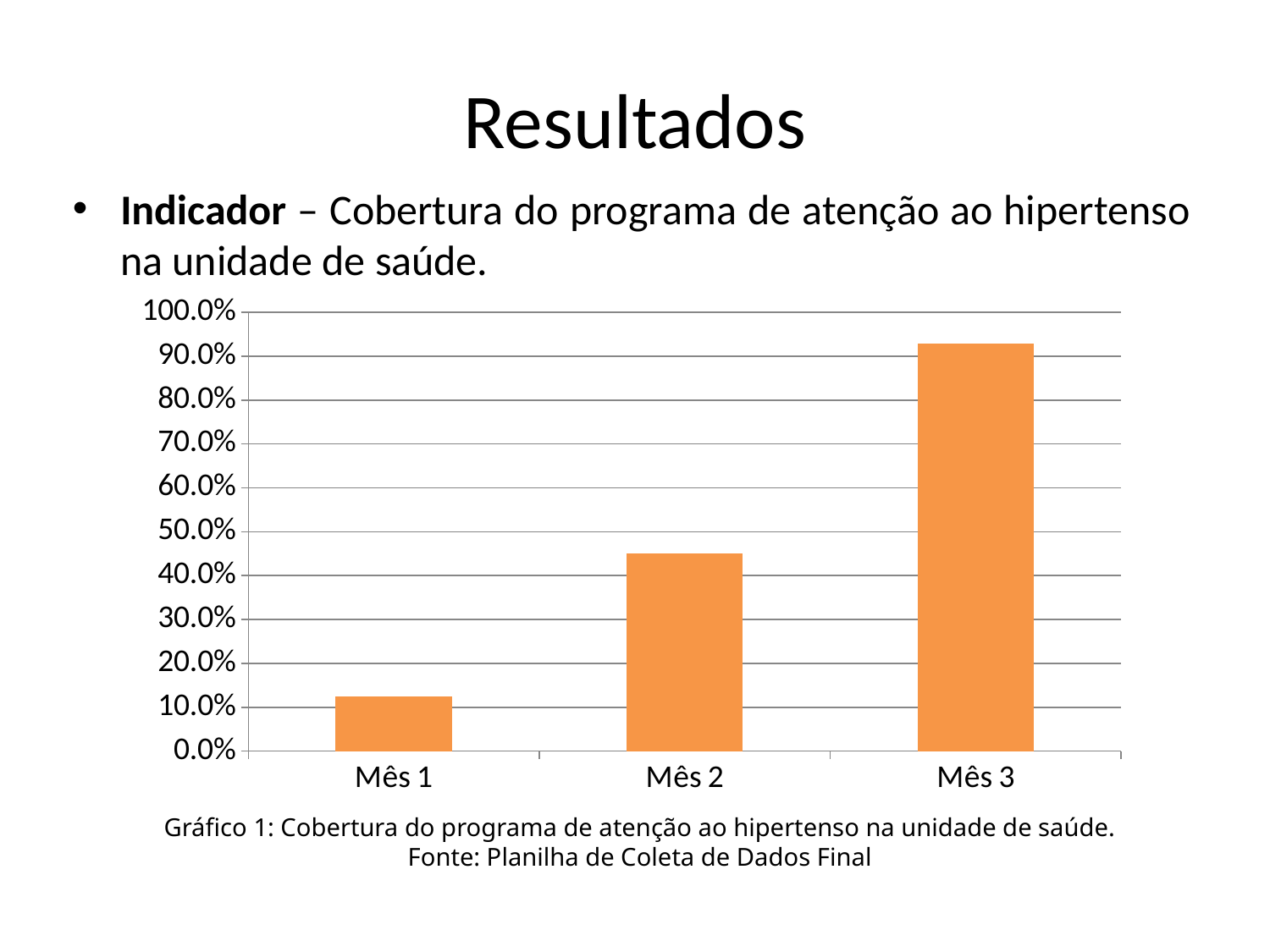
How many categories (months) are plotted on the chart? 3 Which is larger, the value for Mês 2 or the value for Mês 3? Mês 3 Which month has the highest coverage value? Mês 3 What is the caption given for the chart (Gráfico 1)? Cobertura do programa de atenção ao hipertenso na unidade de saúde. Which month has the lowest coverage value? Mês 1 Is the value for Mês 2 greater or less than 50.0%? less Is the value for Mês 2 greater or less than 40.0%? greater What is the maximum value shown on the vertical axis? 100.0% What kind of chart is shown on the slide? bar chart Is the value for Mês 1 greater or less than 20.0%? less Do the values rise or fall from Mês 1 to Mês 3? rise